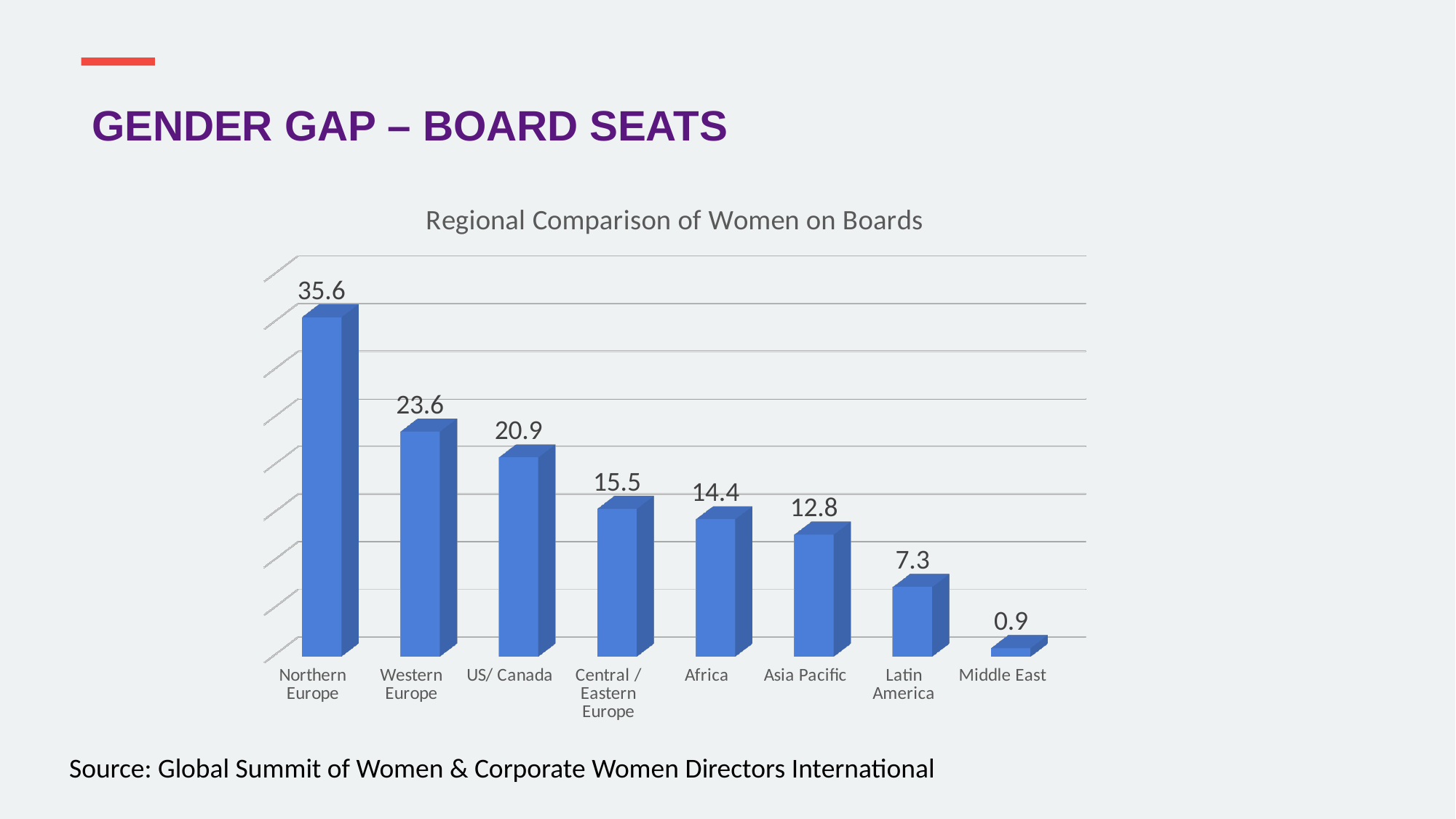
Which is larger, the value for Central / Eastern Europe or the value for Latin America? Central / Eastern Europe What is the value for Middle East? 0.9 What kind of chart is shown on the slide? Bar chart How many regions are shown in the chart? 8 What is the value for Asia Pacific? 12.8 What is the difference between the values for Northern Europe and Western Europe? 12.0 What is the title of the chart? Regional Comparison of Women on Boards Which region has the highest value? Northern Europe Do the values rise or fall from left to right across the regions? Fall Which region has the lowest value? Middle East What is the value for Northern Europe? 35.6 What is the difference between the values for US/ Canada and Africa? 6.5